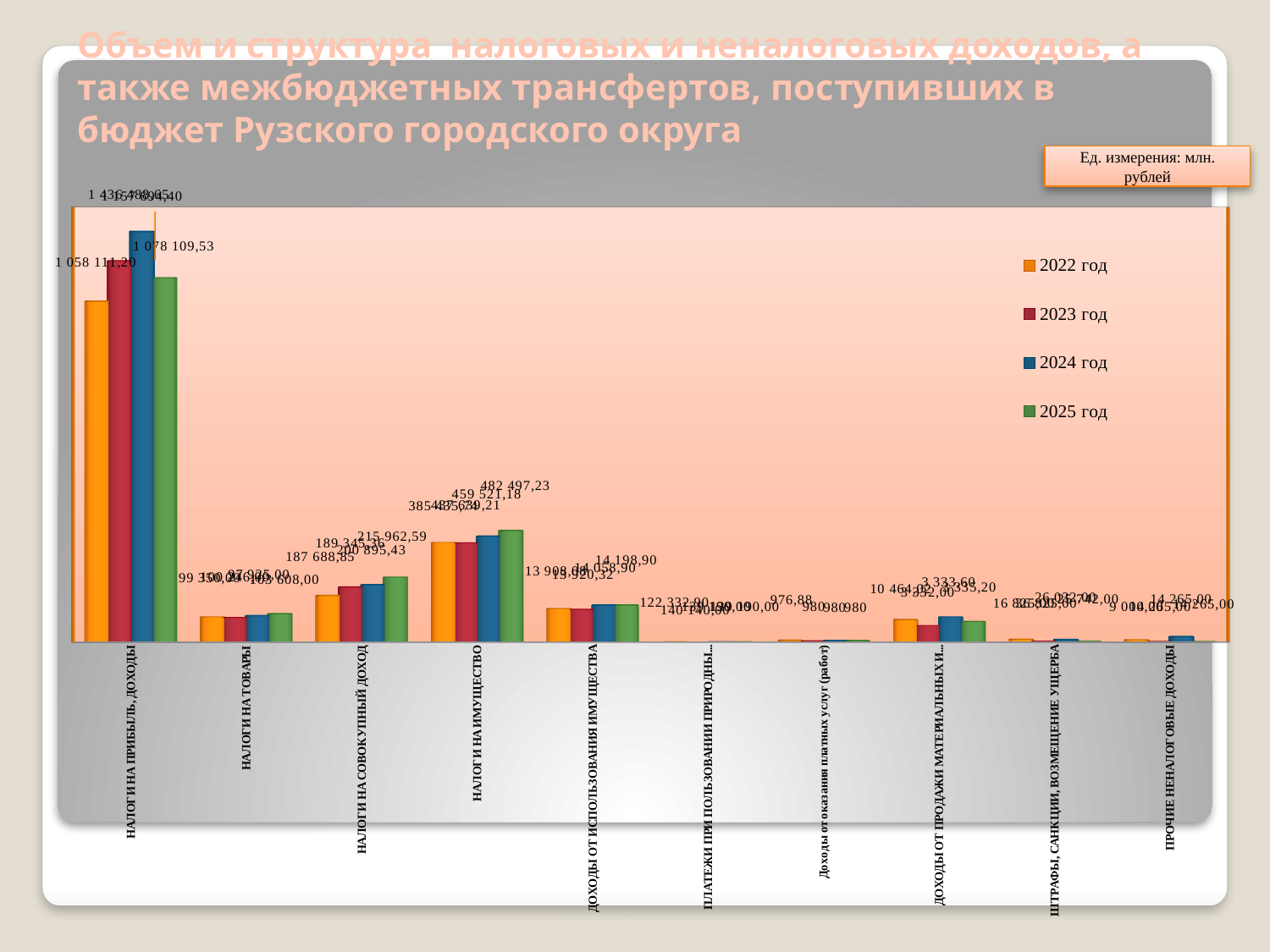
What is the 2025 год value for НАЛОГИ НА СОВОКУПНЫЙ ДОХОД? 215 962,59 What is the 2025 год value for НАЛОГИ НА ИМУЩЕСТВО? 482 497,23 How many series does the legend list? 4 Which years are listed in the legend? 2022 год, 2023 год, 2024 год, 2025 год For НАЛОГИ НА ИМУЩЕСТВО, do the values rise or fall from 2022 год to 2025 год? Rise What type of chart is shown on the slide? Bar chart How many revenue categories are shown on the x axis? 10 What is the difference between the 2025 год and 2024 год values for НАЛОГИ НА ИМУЩЕСТВО? 22 976,05 What is the 2024 год value for НАЛОГИ НА ИМУЩЕСТВО? 459 521,18 Which category has the highest values across all years? НАЛОГИ НА ПРИБЫЛЬ, ДОХОДЫ What is the 2022 год value for НАЛОГИ НА ПРИБЫЛЬ, ДОХОДЫ? 1 058 111,20 In what unit of measurement are the values given, according to the box on the slide? млн. рублей